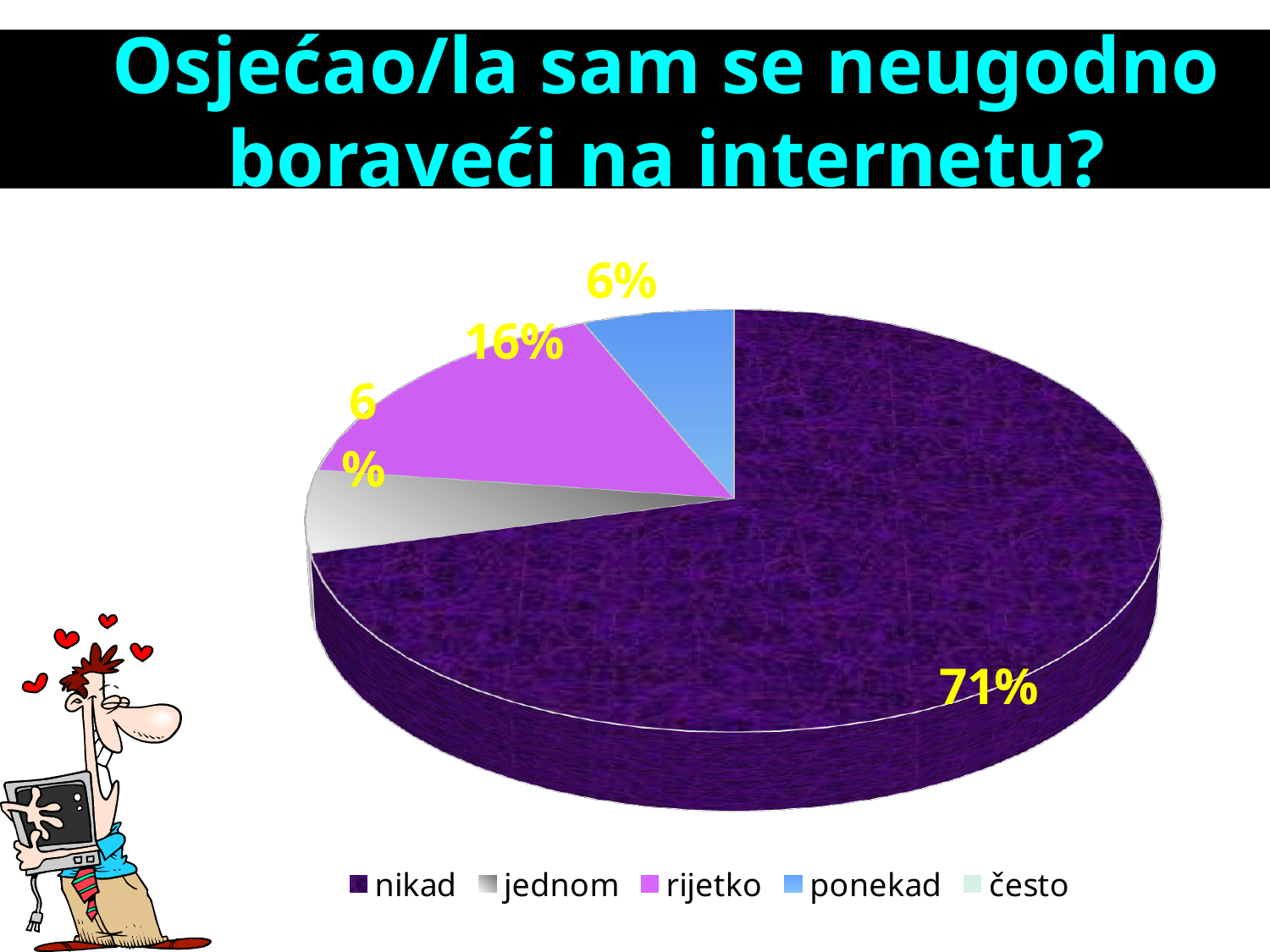
What is the difference between the share for 'nikad' and the share for 'rijetko'? 55% What is the title of the chart? Osjećao/la sam se neugodno boraveći na internetu? What kind of chart is shown on the slide? pie chart How many entries does the legend list? 5 What percentage of the pie is labelled for 'nikad'? 71% What percentage of the pie is labelled for 'jednom'? 6% What percentage of the pie is labelled for 'ponekad'? 6% What colour is the 'nikad' slice? purple Which category has the largest share of the pie? nikad What percentage of the pie is labelled for 'rijetko'? 16% What is the combined share of 'rijetko' and 'ponekad'? 22% Which is larger, the share for 'rijetko' or the share for 'ponekad'? rijetko